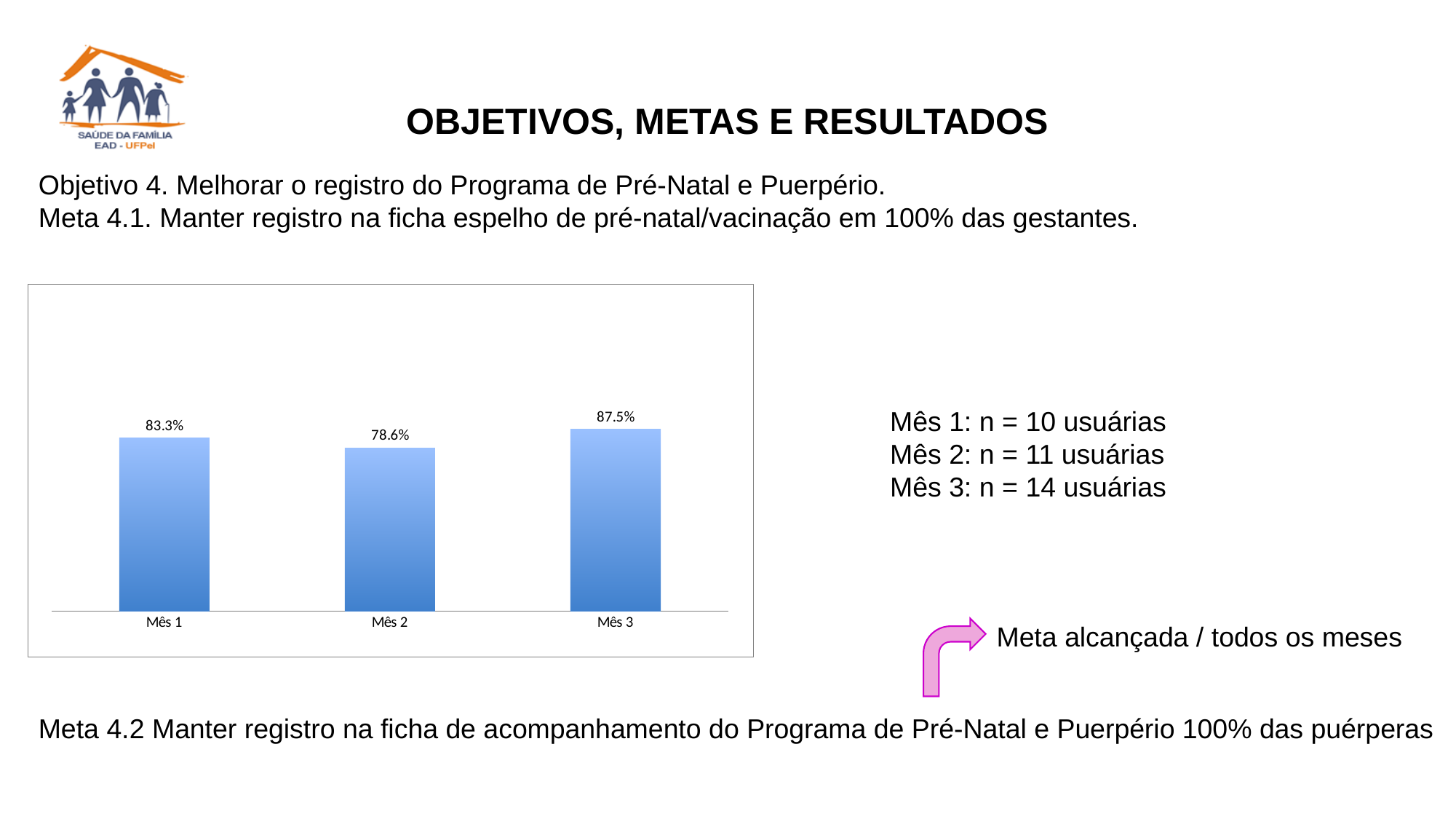
What is the difference between the values for Mês 1 and Mês 2? 4.7 percentage points Does the value rise or fall from Mês 2 to Mês 3? Rises What is the value shown for Mês 2? 78.6% Which month has the lowest value in the chart? Mês 2 What is the value shown for Mês 1? 83.3% What is the difference between the values for Mês 3 and Mês 1? 4.2 percentage points What is the value shown for Mês 3? 87.5% Which month has the highest value in the chart? Mês 3 What kind of chart is shown on the slide? Bar chart How many bars are plotted in the chart? 3 Which is larger, the value for Mês 1 or the value for Mês 2? Mês 1 What is the difference between the values for Mês 3 and Mês 2? 8.9 percentage points